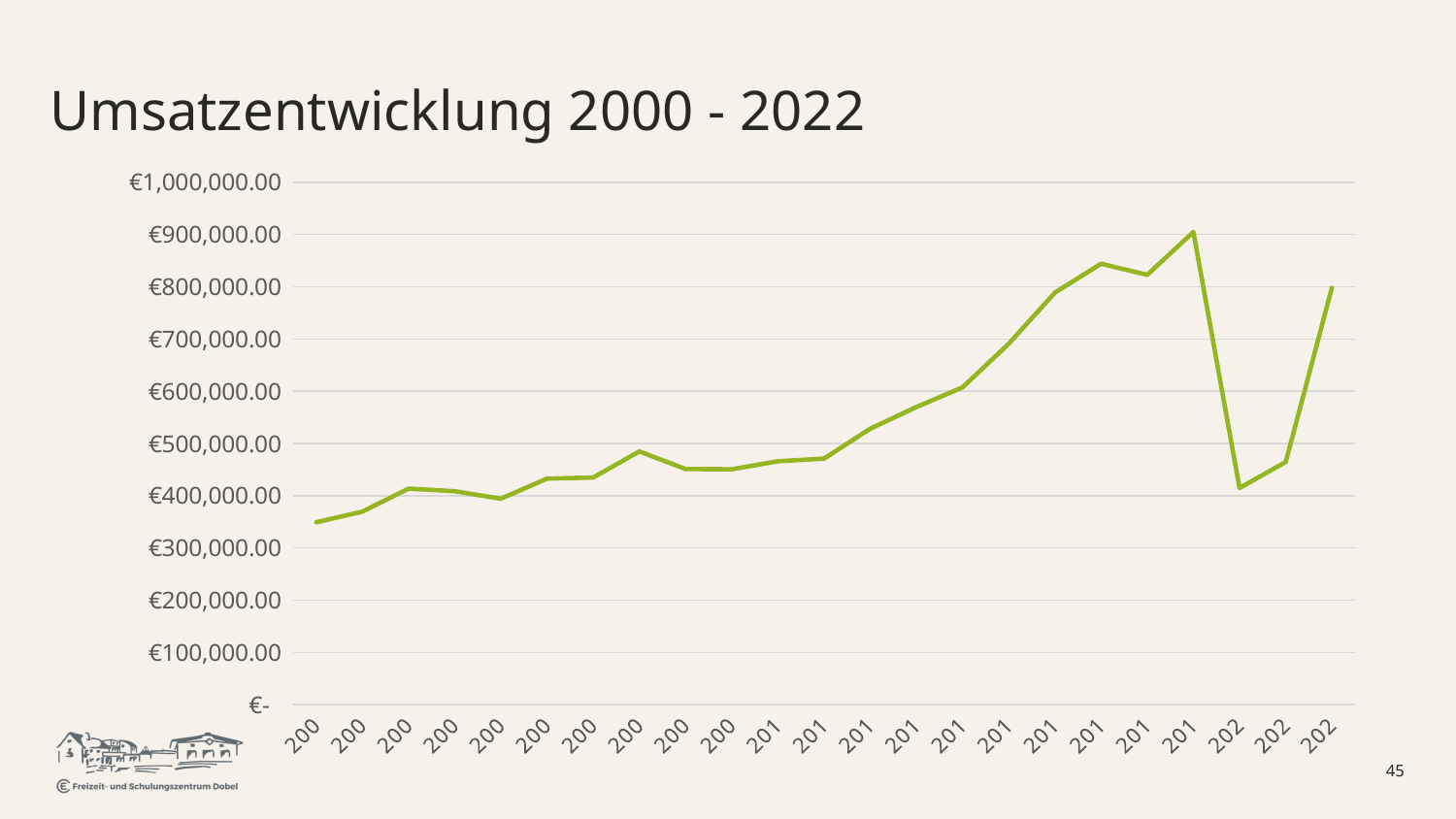
How many data points are plotted on the line? 23 What is the title of the chart? Umsatzentwicklung 2000 - 2022 What kind of chart is shown on the slide? line chart Which is larger, the value at the first point of the line or the value at the last point of the line? the last point Is the lowest point of the line after the peak greater or less than €500,000.00? less Is the highest point of the line greater or less than €800,000.00? greater What is the highest value shown on the y axis? €1,000,000.00 Which is larger, the value at the peak of the line or the value at the last point of the line? the peak Does the line rise or fall immediately after its highest point? fall Is the value at the first point of the line (year 2000) greater or less than €300,000.00? greater Does the line generally rise or fall between the first point (2000) and its peak? rise